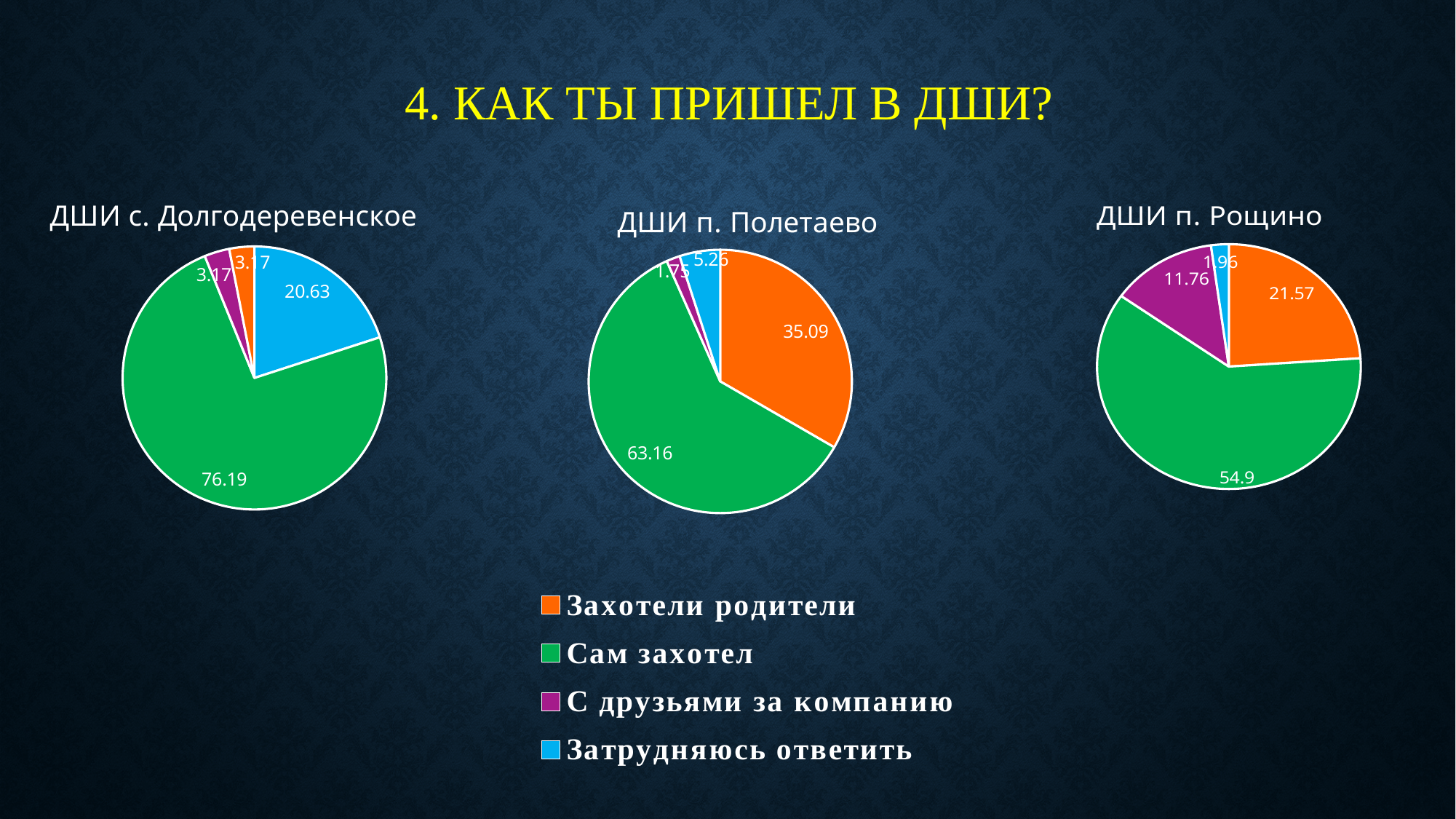
In the chart titled "ДШИ п. Полетаево", which category has the smallest slice? С друзьями за компанию What kind of chart is used on this slide? Pie chart In the chart titled "ДШИ п. Рощино", what is the value for "С друзьями за компанию"? 11.76 In the chart titled "ДШИ п. Полетаево", what is the value for "Сам захотел"? 63.16 In the chart titled "ДШИ п. Рощино", which category has the largest slice? Сам захотел In the chart titled "ДШИ п. Полетаево", what is the difference between the values for "Сам захотел" and "Захотели родители"? 28.07 In the chart titled "ДШИ п. Рощино", what is the value for "Захотели родители"? 21.57 Which is larger in the chart titled "ДШИ п. Рощино": the value for "Захотели родители" or the value for "С друзьями за компанию"? Захотели родители In the chart titled "ДШИ с. Долгодеревенское", what is the value for "Сам захотел"? 76.19 In the chart titled "ДШИ п. Полетаево", what is the value for "Захотели родители"? 35.09 How many entries does the legend list? 4